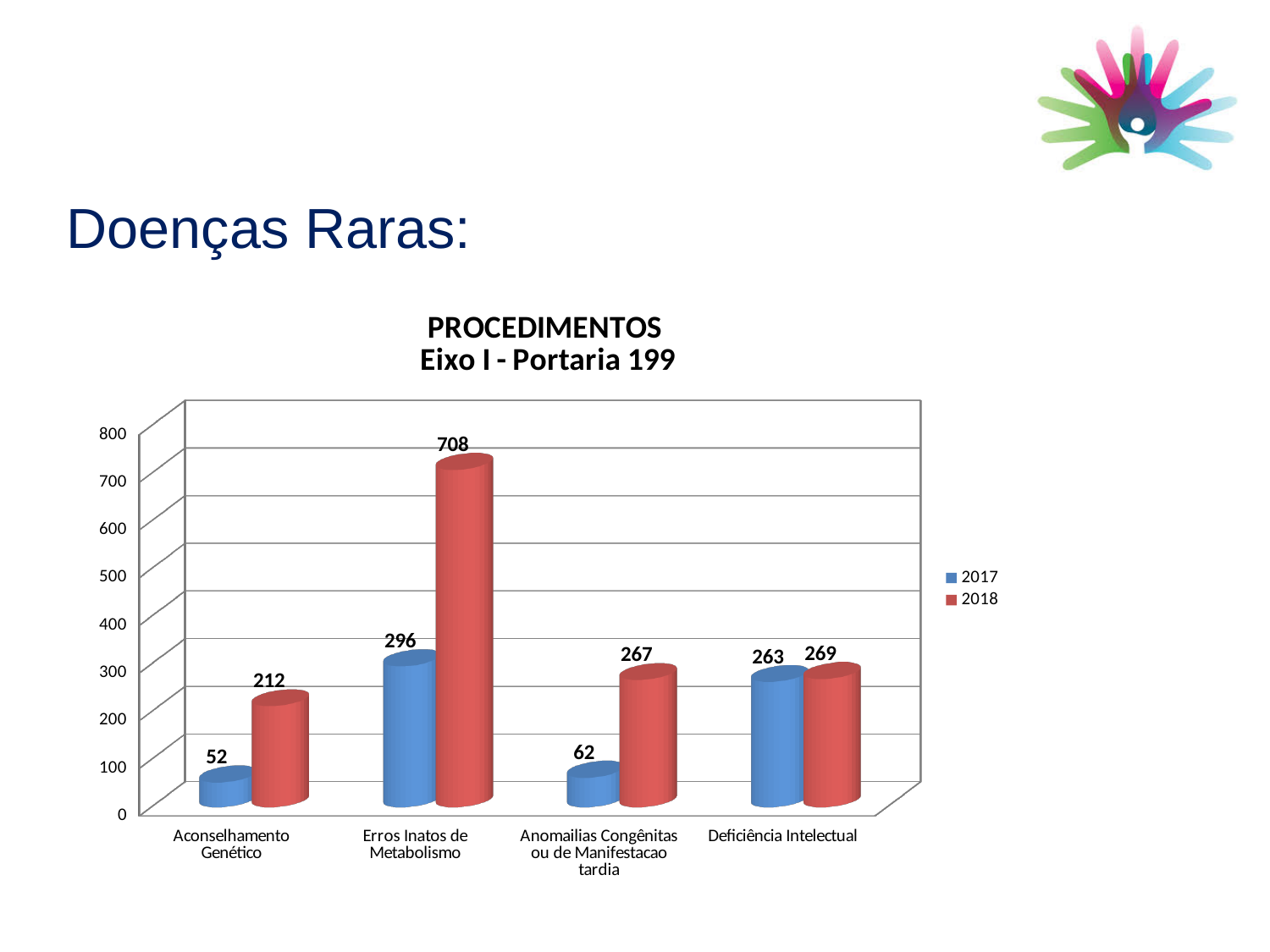
Which category has the lowest value in 2017? Aconselhamento Genético How many series does the legend list? 2 Which is larger: the 2017 value for Erros Inatos de Metabolismo or the 2018 value for Anomailias Congênitas ou de Manifestacao tardia? 2017 value for Erros Inatos de Metabolismo What is the title of the chart? PROCEDIMENTOS Eixo I - Portaria 199 What is the difference between the 2018 and 2017 values for Erros Inatos de Metabolismo? 412 What kind of chart is shown on the slide? Bar chart What is the difference between the 2018 and 2017 values for Anomailias Congênitas ou de Manifestacao tardia? 205 What is the value for Erros Inatos de Metabolismo in 2018? 708 What is the value for Aconselhamento Genético in 2017? 52 How many categories are shown on the x axis? 4 What is the value for Deficiência Intelectual in 2018? 269 Which category has the highest value in 2018? Erros Inatos de Metabolismo